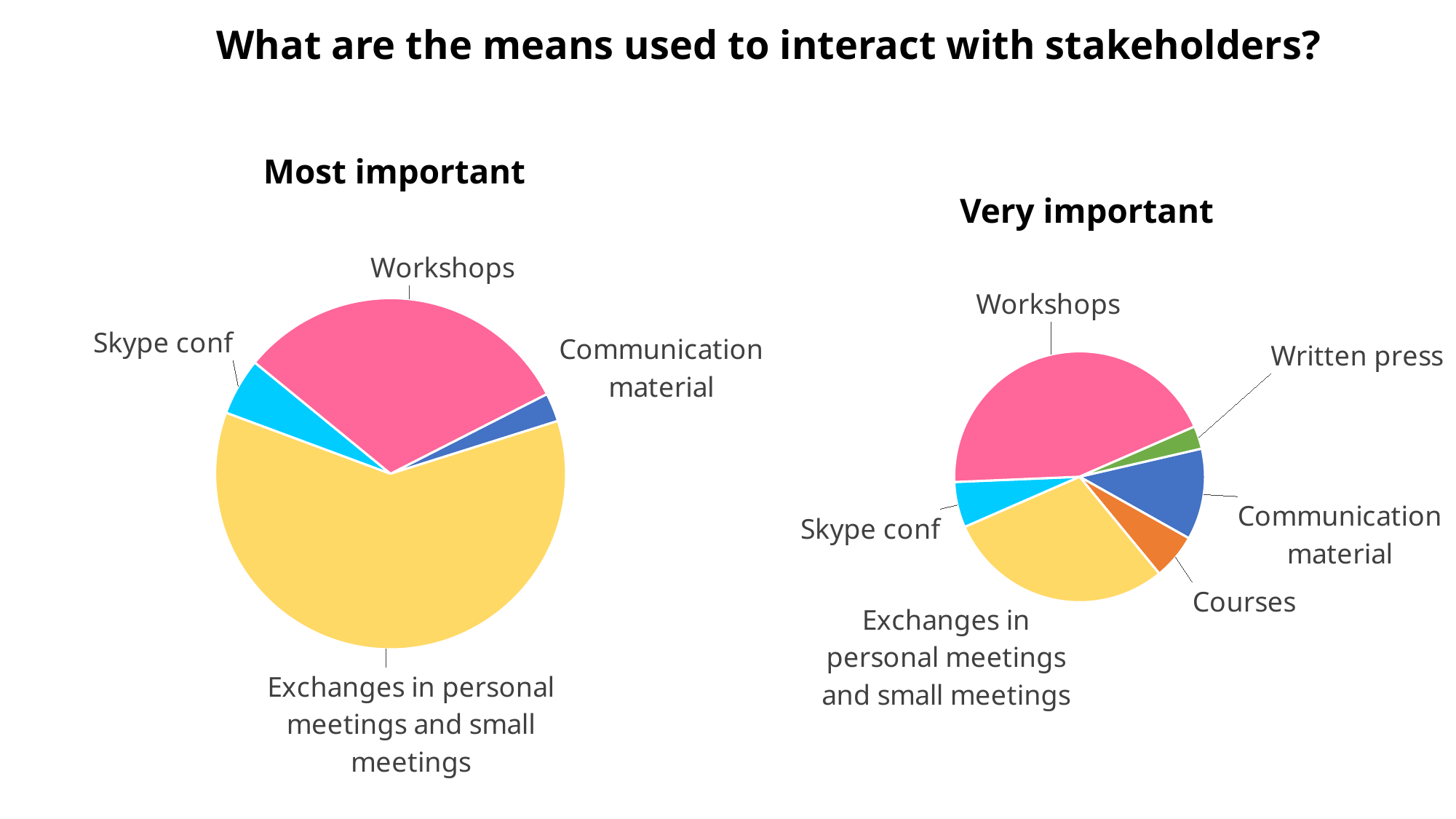
What is the title of the slide? What are the means used to interact with stakeholders? How many slices does the "Very important" pie chart have? 6 What kind of chart is the "Very important" chart? pie chart In the "Very important" chart, which slice is larger: Communication material or Skype conf? Communication material In the "Most important" chart, which category has the largest slice? Exchanges in personal meetings and small meetings Which category appears in the "Very important" chart but not in the "Most important" chart, besides Written press? Courses In the "Most important" chart, which slice is larger: Workshops or Skype conf? Workshops In the "Very important" chart, which slice is larger: Workshops or Courses? Workshops How many slices does the "Most important" pie chart have? 4 In the "Very important" chart, which category has the smallest slice? Written press What kind of chart is the "Most important" chart? pie chart In the "Most important" chart, which category has the smallest slice? Communication material